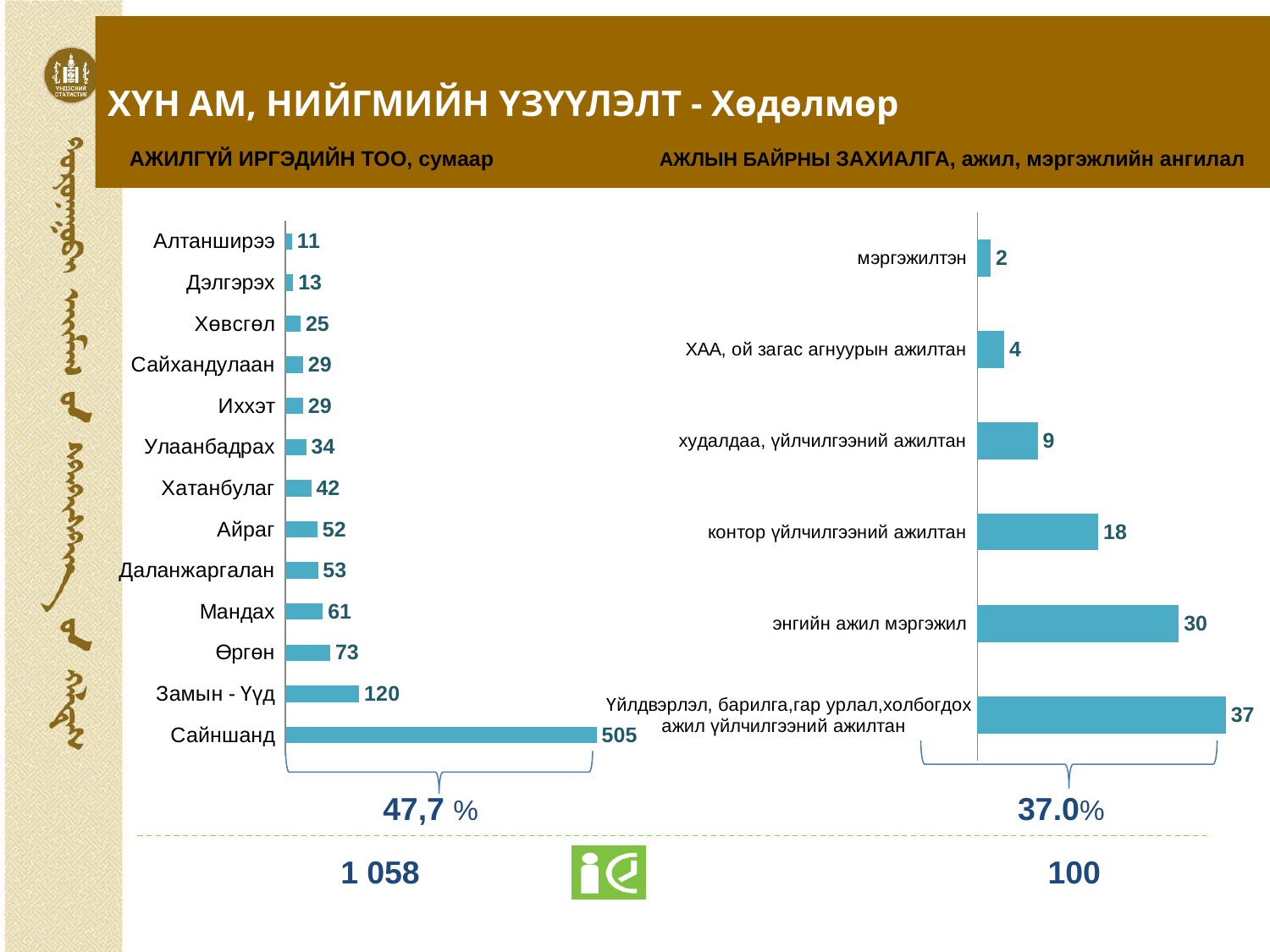
In the left chart (АЖИЛГҮЙ ИРГЭДИЙН ТОО, сумаар), what is the value for Замын - Үүд? 120 In the right chart (АЖЛЫН БАЙРНЫ ЗАХИАЛГА), what is the value for контор үйлчилгээний ажилтан? 18 In the right chart (АЖЛЫН БАЙРНЫ ЗАХИАЛГА), how many categories are shown? 6 In the left chart (АЖИЛГҮЙ ИРГЭДИЙН ТОО, сумаар), how many categories are shown? 13 In the left chart (АЖИЛГҮЙ ИРГЭДИЙН ТОО, сумаар), what is the value for Сайншанд? 505 In the left chart (АЖИЛГҮЙ ИРГЭДИЙН ТОО, сумаар), which category has the lowest value? Алтанширээ In the right chart (АЖЛЫН БАЙРНЫ ЗАХИАЛГА), what is the difference between the values for энгийн ажил мэргэжил and худалдаа, үйлчилгээний ажилтан? 21 What type of chart is the right chart (АЖЛЫН БАЙРНЫ ЗАХИАЛГА)? Bar chart In the left chart (АЖИЛГҮЙ ИРГЭДИЙН ТОО, сумаар), which category has the highest value? Сайншанд In the left chart (АЖИЛГҮЙ ИРГЭДИЙН ТОО, сумаар), what is the difference between the values for Өргөн and Мандах? 12 In the right chart (АЖЛЫН БАЙРНЫ ЗАХИАЛГА), which category has the highest value? Үйлдвэрлэл, барилга,гар урлал,холбогдох ажил үйлчилгээний ажилтан In the left chart (АЖИЛГҮЙ ИРГЭДИЙН ТОО, сумаар), which is larger, the value for Хатанбулаг or the value for Айраг? Айраг